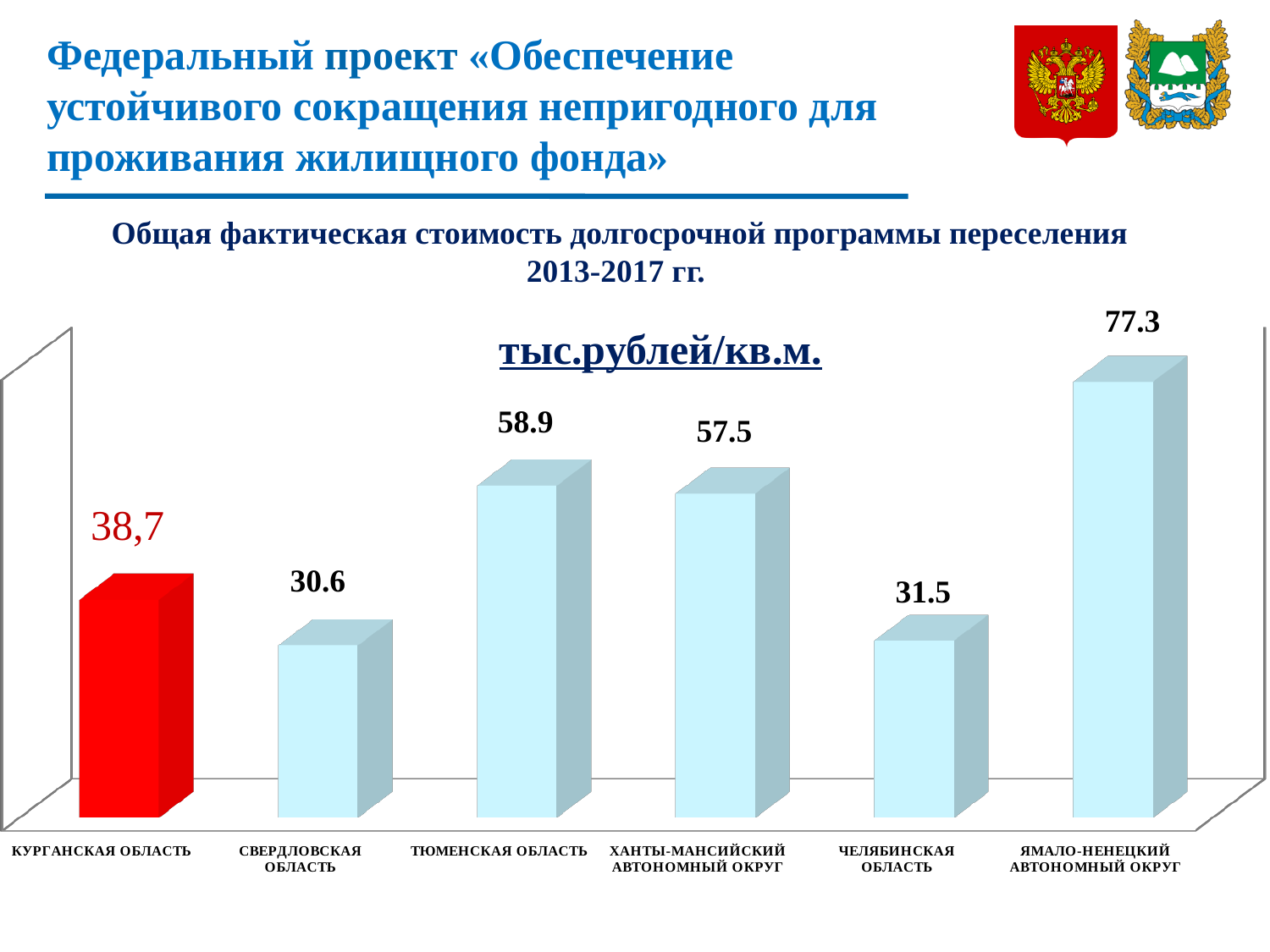
Which is larger, the value for Тюменская область or for Ханты-Мансийский автономный округ? Тюменская область Which region has the highest value? Ямало-Ненецкий автономный округ What is the difference between the values for Ямало-Ненецкий автономный округ and Свердловская область? 46.7 What is the value for Ямало-Ненецкий автономный округ? 77.3 What is the difference between the values for Тюменская область and Ханты-Мансийский автономный округ? 1.4 What is the value for Ханты-Мансийский автономный округ? 57.5 What is the value for Курганская область? 38,7 How many regions are shown in the chart? 6 What is the value for Свердловская область? 30.6 Which region has the lowest value? Свердловская область Which region's bar is coloured red? Курганская область What kind of chart is shown on the slide? Bar chart